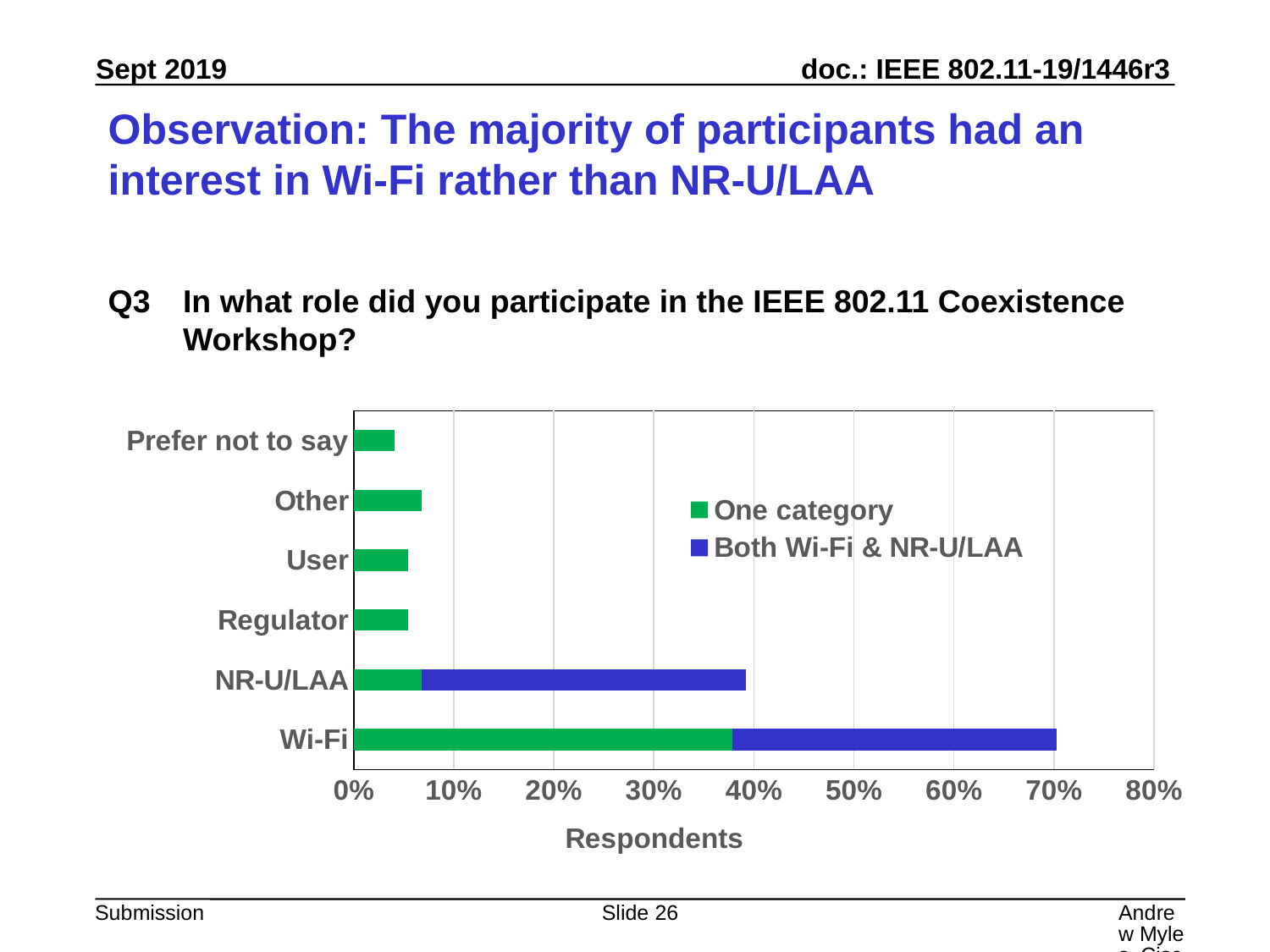
Which category has the longest total bar? Wi-Fi Is the value for Prefer not to say greater or less than 10%? less How many categories are shown on the vertical axis of the chart? 6 What kind of chart is shown on the slide? bar chart Which series in the legend is shown in blue? Both Wi-Fi & NR-U/LAA What is the title of the horizontal axis of the chart? Respondents Which has the larger total bar, Wi-Fi or NR-U/LAA? Wi-Fi How many series does the chart legend list? 2 Is the total value for Wi-Fi greater or less than 60%? greater Which has the larger bar, Other or Prefer not to say? Other Is the value for Other greater or less than 10%? less